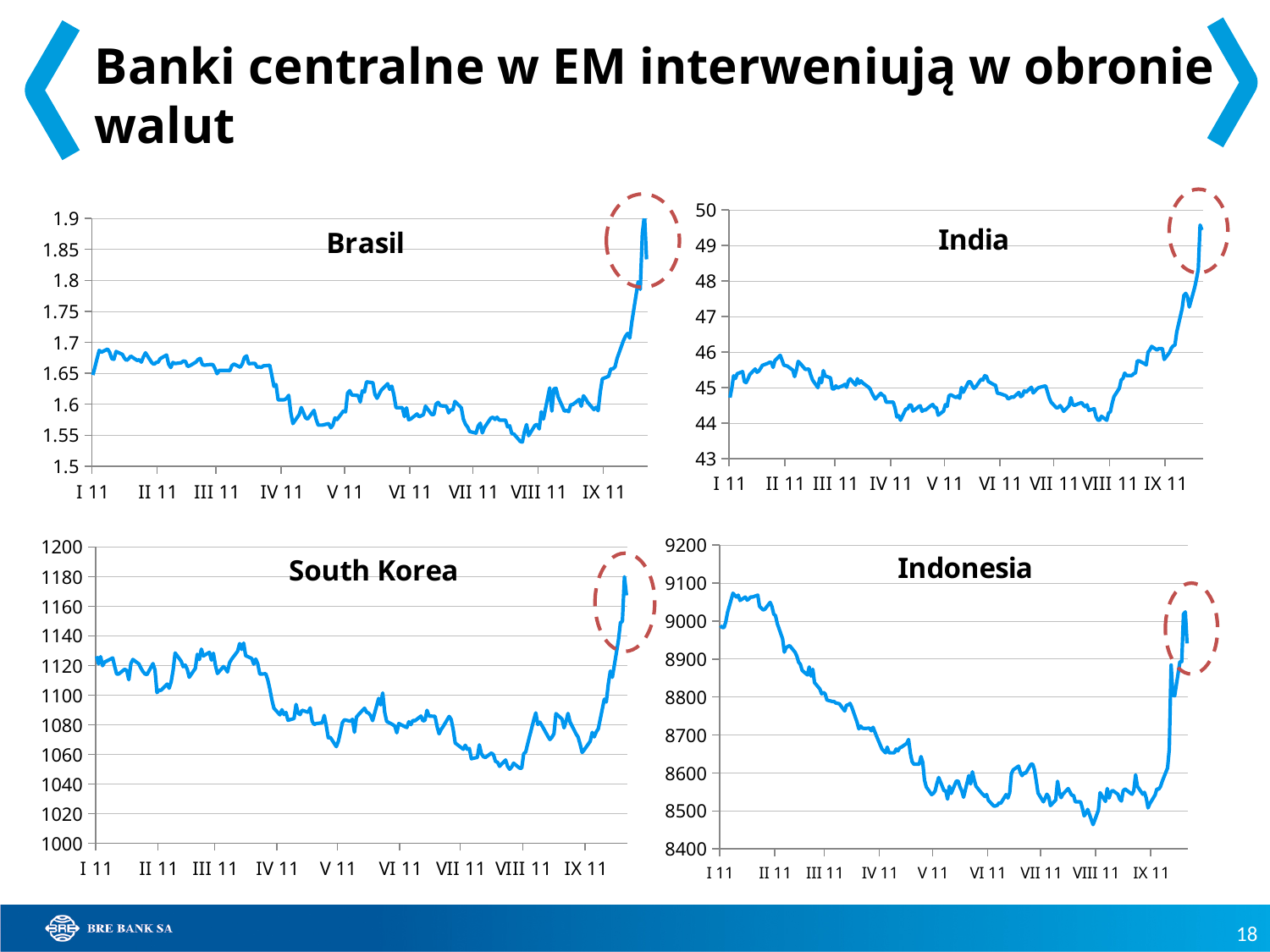
On the Indonesia chart, does the line rise or fall between I 11 and V 11? fall How many charts are shown on the slide? 4 On the India chart, does the line rise or fall between VIII 11 and IX 11? rise On the India chart, is the value at I 11 greater or less than 46? less On the India chart, is the peak value at the end of the series greater or less than 49? greater What is the title of the top-right chart? India On the South Korea chart, is the lowest value around VIII 11 greater or less than 1080? less Which chart has a vertical axis running from 1000 to 1200? South Korea What kind of chart is the Brasil chart? line chart